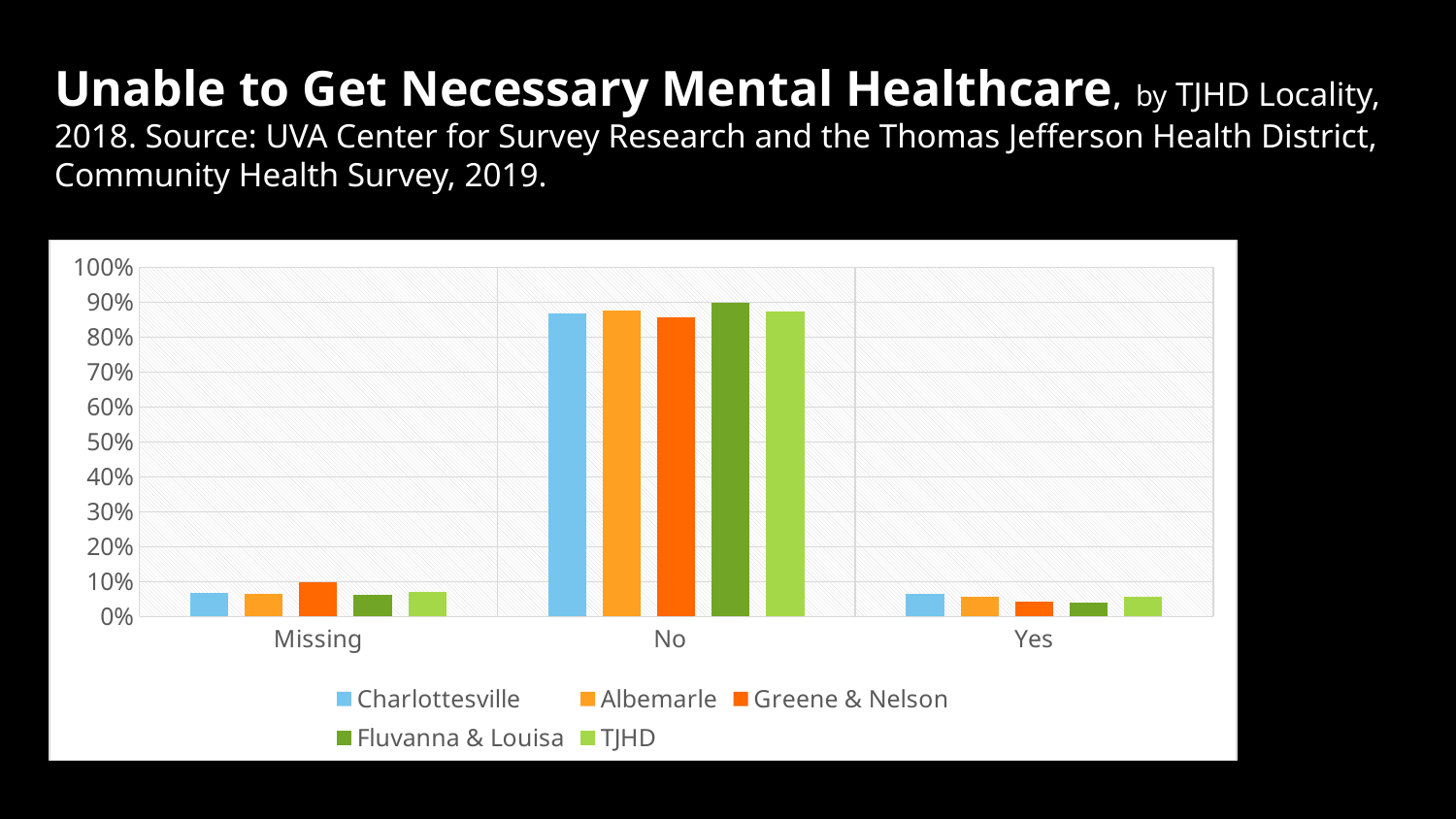
Is the value for Fluvanna & Louisa in the No category greater or less than 50%? greater Which is larger for Greene & Nelson: the Missing value or the Yes value? Missing Which is larger for TJHD: the No value or the Yes value? No Which series has the highest value in the Missing category? Greene & Nelson Which category has the highest values across all series? No Is the value for Fluvanna & Louisa in the Yes category greater or less than 10%? less Is the value for Charlottesville in the No category greater or less than 80%? greater How many series does the legend list? 5 How many categories are shown on the x axis? 3 What kind of chart is shown on the slide? bar chart Which series is shown in light blue in the legend? Charlottesville